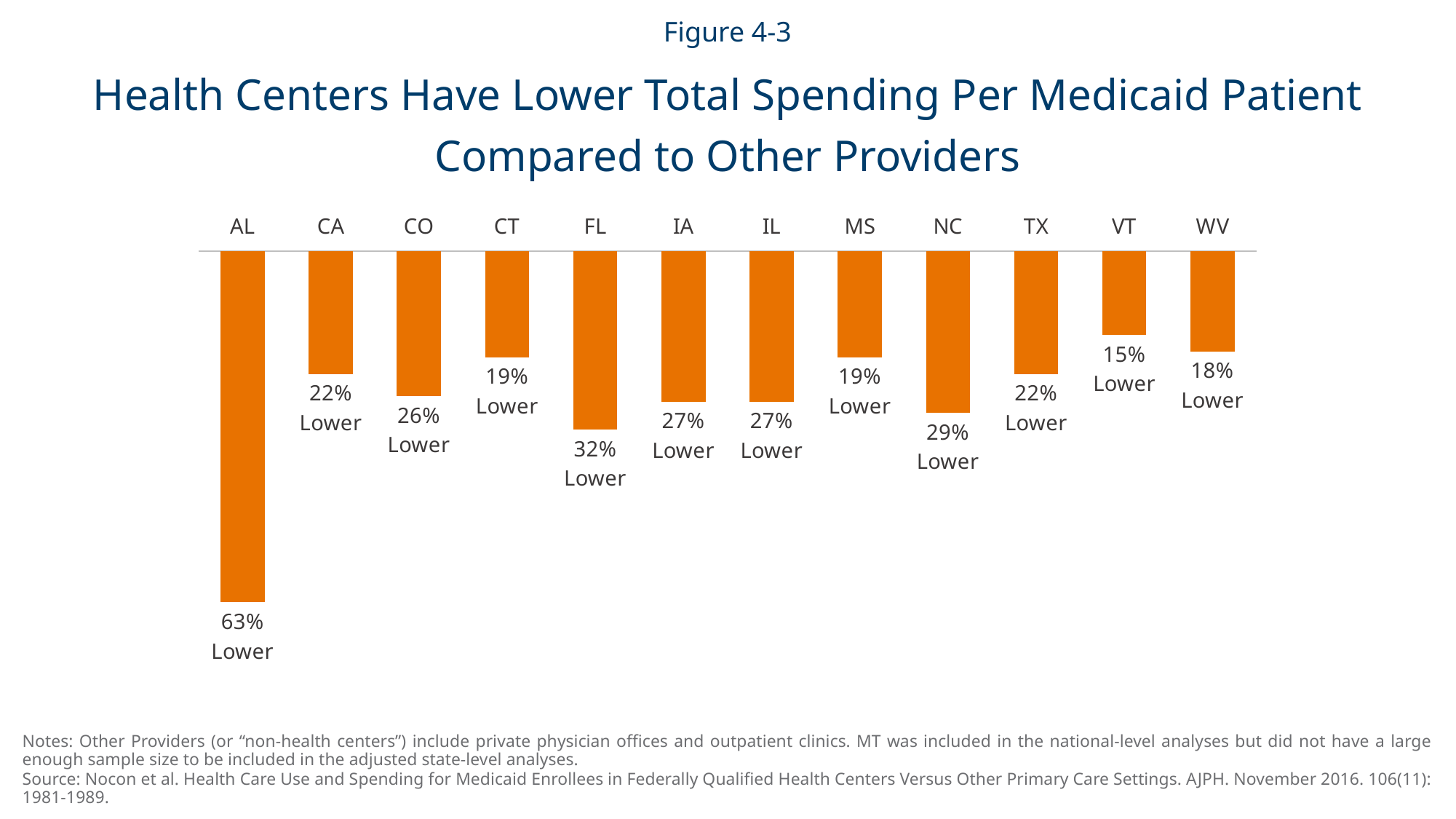
What is the difference in percentage points between AL and NC? 34 What is the value shown for VT? 15% Lower Which has a larger percentage lower spending, CO or TX? CO What is the value shown for FL? 32% Lower Which state shows the largest percentage lower spending? AL What is the difference in percentage points between FL and WV? 14 Which state shows the smallest percentage lower spending? VT How many states are shown in the chart? 12 What kind of chart is shown on the slide? Bar chart Which has a larger percentage lower spending, NC or IA? NC What is the figure number shown above the chart title? Figure 4-3 What is the value shown for AL? 63% Lower